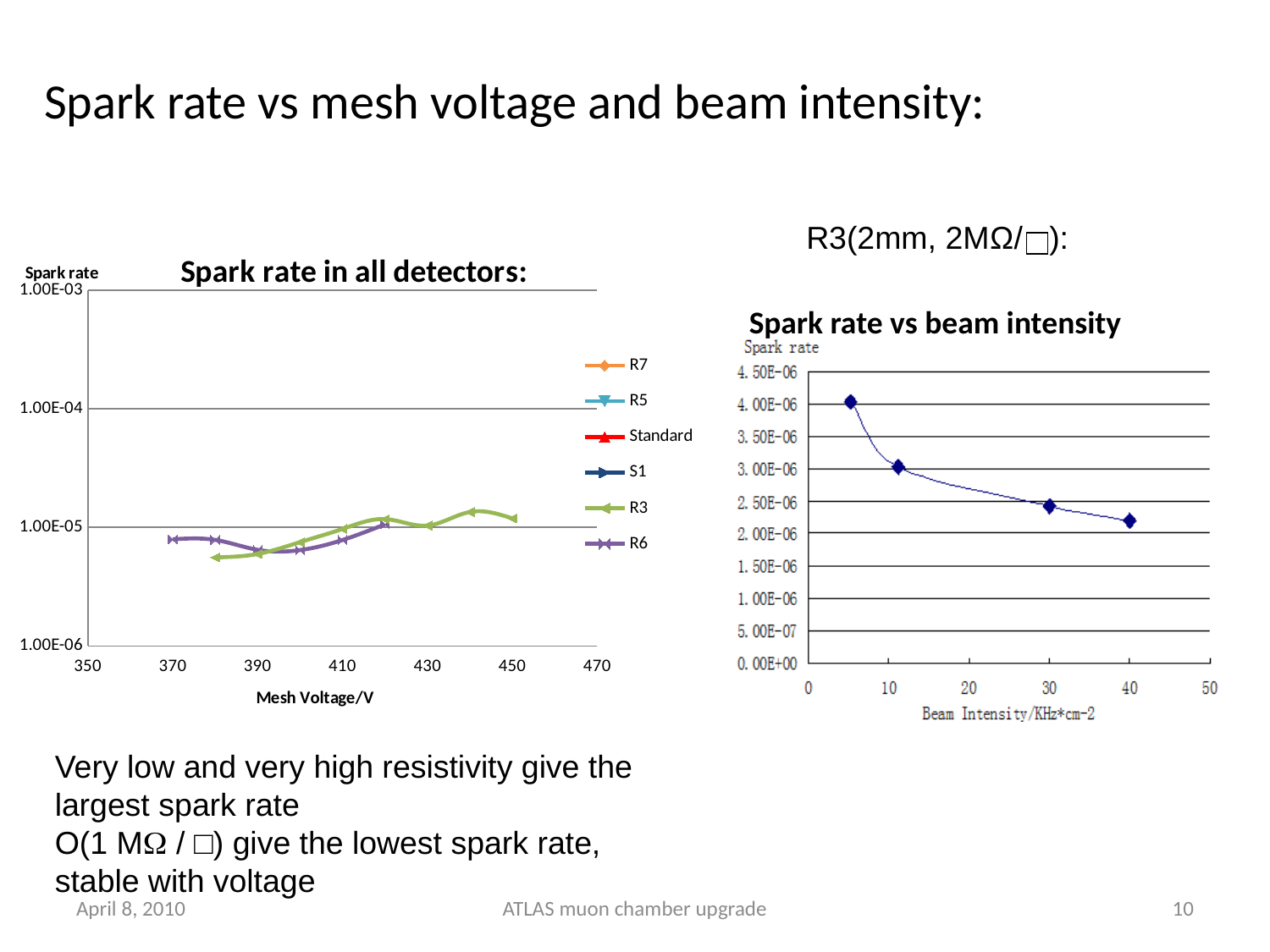
On the 'Spark rate in all detectors' chart, is the R6 value at 400 V greater or less than 1.00E-05? less On the 'Spark rate vs beam intensity' chart, does the spark rate rise or fall as beam intensity increases? fall On the 'Spark rate vs beam intensity' chart, how many data points are plotted? 4 On the 'Spark rate vs beam intensity' chart, is the spark rate at beam intensity 40 greater or less than 1.50E-06? greater On the 'Spark rate vs beam intensity' chart, is the spark rate at the lowest beam intensity greater or less than 3.50E-06? greater On the 'Spark rate in all detectors' chart, how many series does the legend list? 6 What kind of chart is 'Spark rate vs beam intensity'? line chart On the 'Spark rate in all detectors' chart, what is the x-axis title? Mesh Voltage/V On the 'Spark rate in all detectors' chart, what is the highest value shown on the y-axis? 1.00E-03